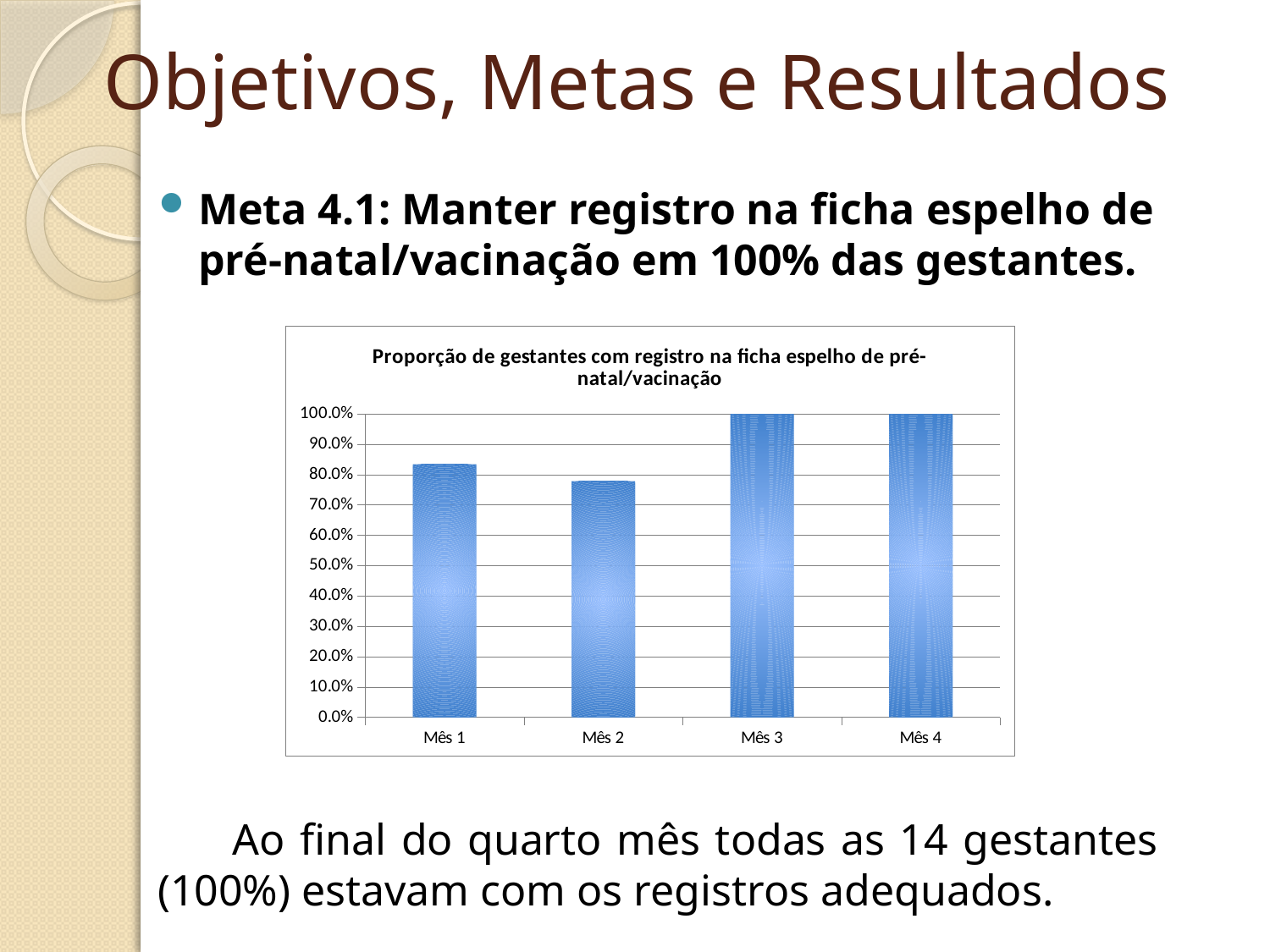
Is the value for Mês 1 greater or less than 80.0%? greater Which is larger, the value for Mês 1 or the value for Mês 2? Mês 1 From Mês 2 to Mês 4, do the values rise or fall? rise Is the value for Mês 1 greater or less than 90.0%? less What kind of chart is shown on the slide? bar chart Which is larger, the value for Mês 2 or the value for Mês 3? Mês 3 What is the title of the chart? Proporção de gestantes com registro na ficha espelho de pré-natal/vacinação Is the value for Mês 2 greater or less than 80.0%? less What is the value for Mês 4 in the chart? 100.0% Which month has the lowest value in the chart? Mês 2 What is the value for Mês 3 in the chart? 100.0% How many months (categories) are shown on the x axis of the chart? 4